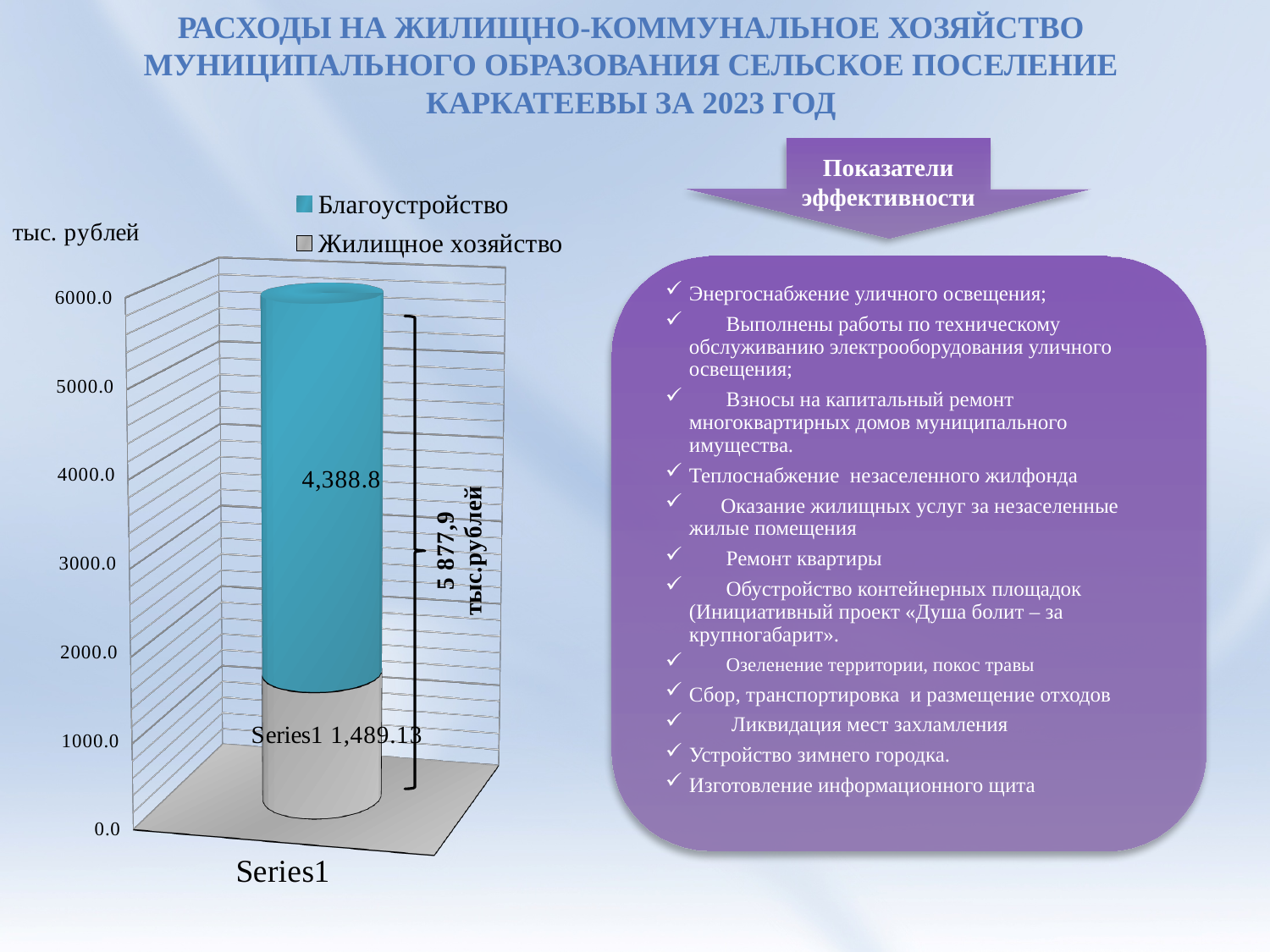
Which series has the larger value in the bar chart, Благоустройство or Жилищное хозяйство? Благоустройство How many series does the legend of the bar chart list? 2 What unit label is shown above the y axis of the bar chart? тыс. рублей What is the value of the Жилищное хозяйство segment in the bar chart? 1,489.13 What total is annotated next to the stacked bar in the chart? 5 877,9 тыс.рублей What is the difference between the Благоустройство value and the Жилищное хозяйство value in the bar chart? 2,899.67 What colour is the Благоустройство series in the bar chart? Teal (blue-green) Is the value for Жилищное хозяйство greater or less than 2000.0? less What is the value of the Благоустройство segment in the bar chart? 4,388.8 How many categories are shown on the x axis of the bar chart? 1 What kind of chart is shown on the slide? Stacked bar chart Which series has the smallest value in the bar chart? Жилищное хозяйство